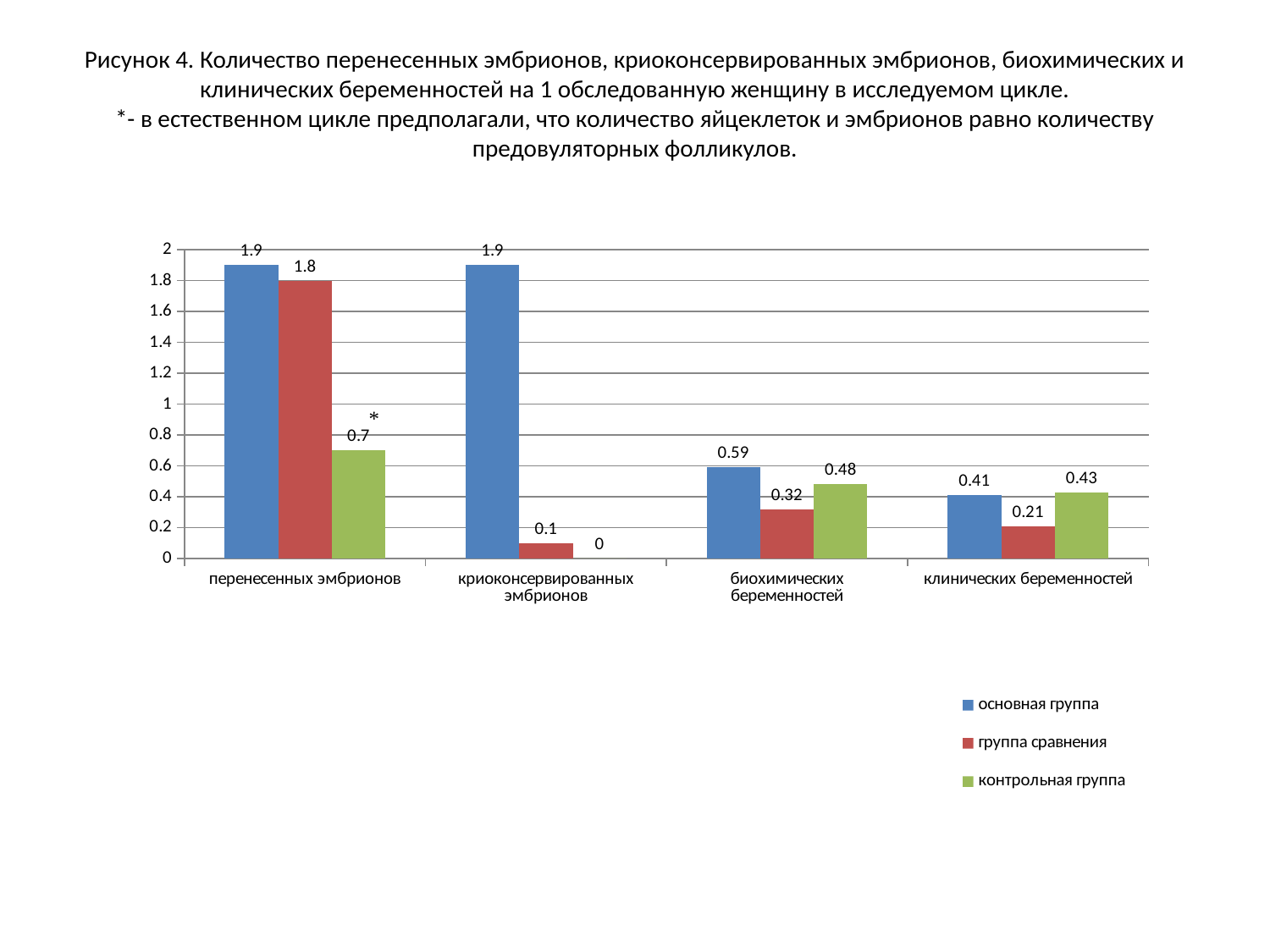
In the клинических беременностей category, which is larger: основная группа or группа сравнения? основная группа What is the value for контрольная группа in the биохимических беременностей category? 0.48 What is the value for группа сравнения in the криоконсервированных эмбрионов category? 0.1 Which series has the highest value in the биохимических беременностей category? основная группа What is the value for контрольная группа in the перенесенных эмбрионов category? 0.7 How many series does the legend list? 3 What is the value for группа сравнения in the клинических беременностей category? 0.21 What kind of chart is shown on the slide? bar chart What is the value for основная группа in the перенесенных эмбрионов category? 1.9 What is the difference between основная группа and группа сравнения in the биохимических беременностей category? 0.27 Which series has the lowest value in the криоконсервированных эмбрионов category? контрольная группа How many categories are shown on the x axis? 4